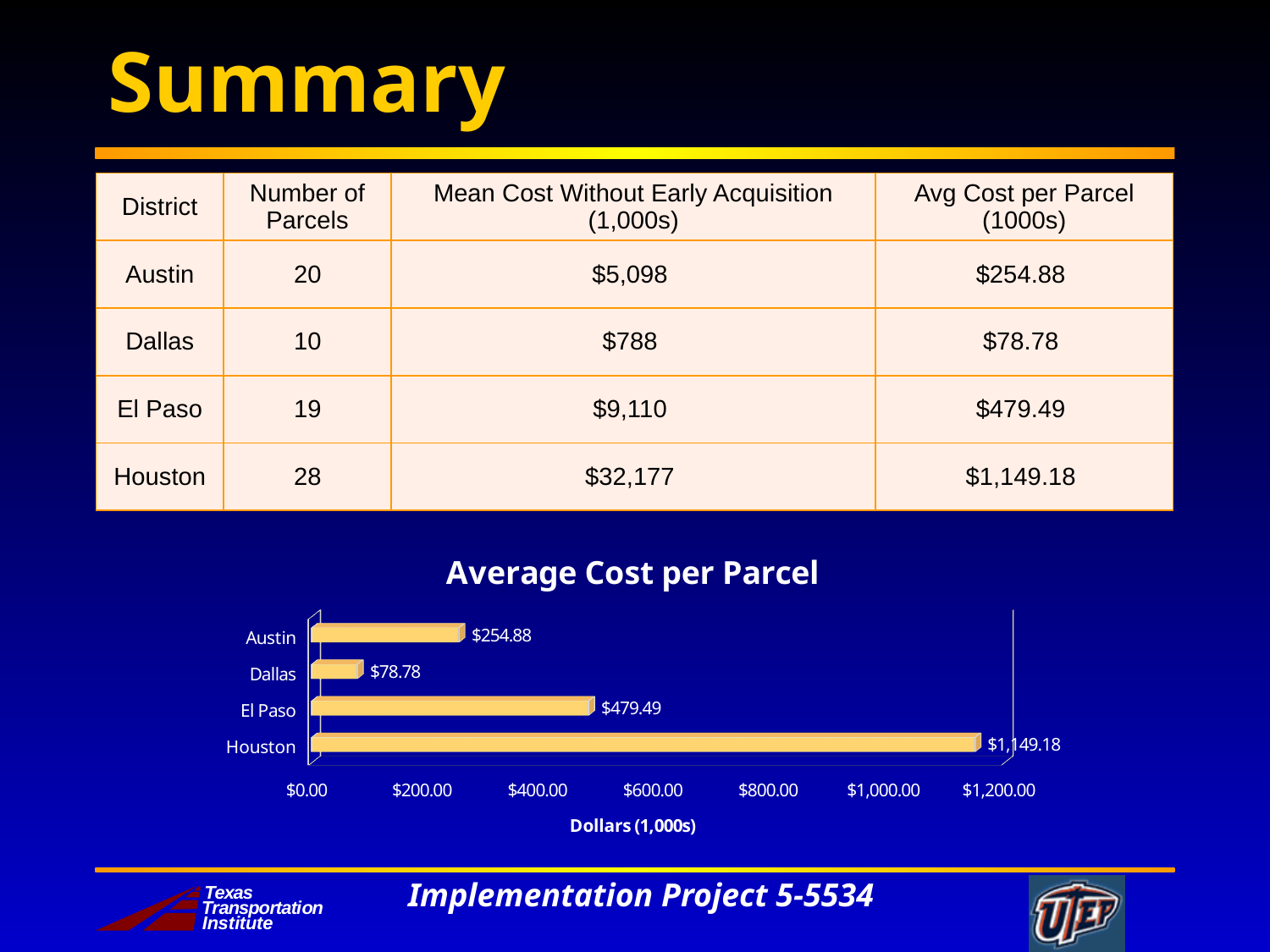
Is the value for Houston in the chart greater or less than $1,000.00? greater What is the difference between the average cost per parcel for El Paso and Austin in the chart? $224.61 What is the average cost per parcel for Houston in the chart? $1,149.18 Which district has the highest average cost per parcel in the chart? Houston Which has a larger average cost per parcel in the chart, Austin or El Paso? El Paso What is the average cost per parcel for Dallas in the chart? $78.78 What is the average cost per parcel for Austin in the chart? $254.88 How many districts are shown in the chart? 4 What is the average cost per parcel for El Paso in the chart? $479.49 What is the title of the chart on the slide? Average Cost per Parcel What kind of chart is shown on the slide? Bar chart Which district has the lowest average cost per parcel in the chart? Dallas